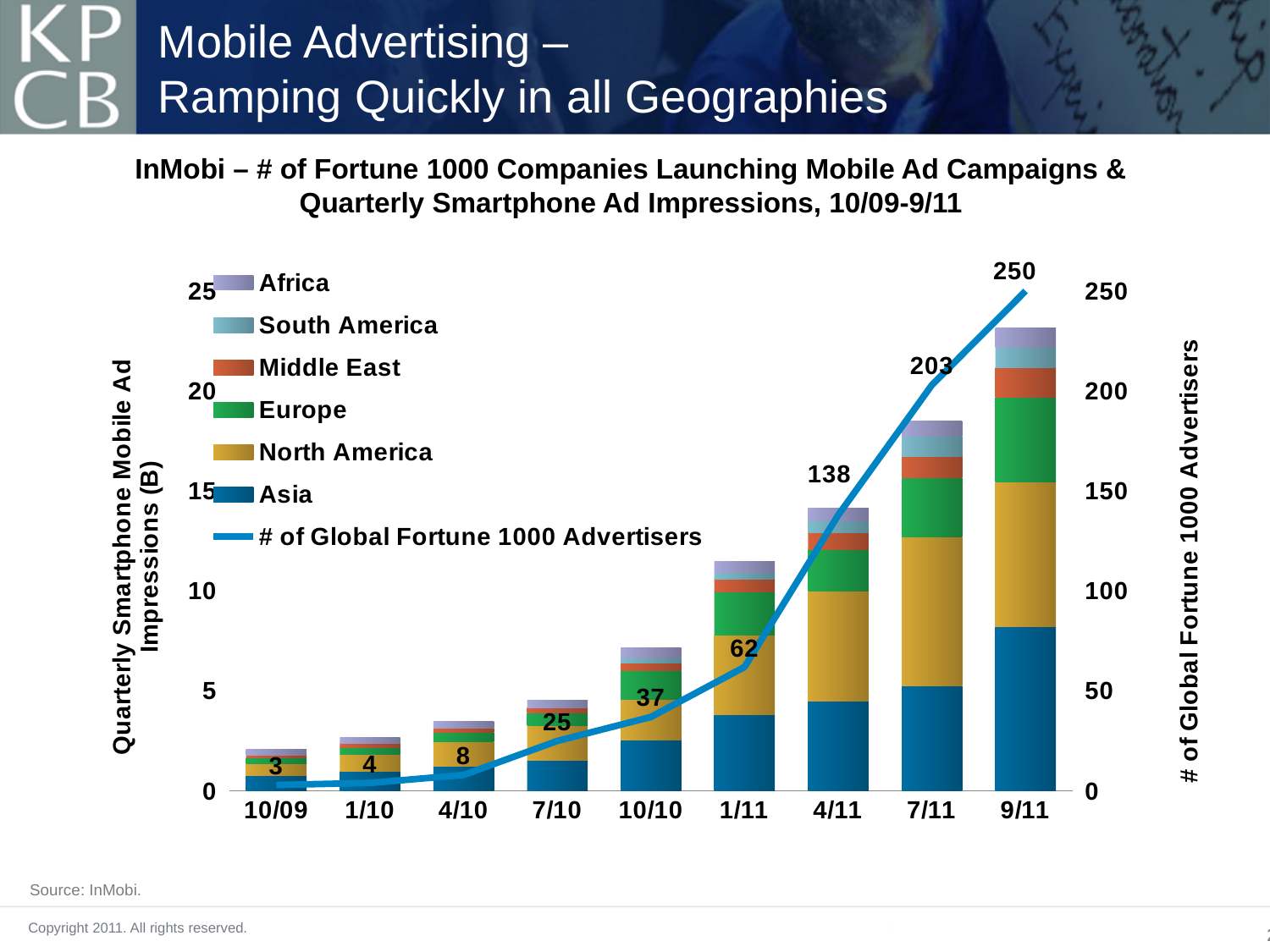
In which period is the # of Global Fortune 1000 Advertisers lowest? 10/09 What is the difference in # of Global Fortune 1000 Advertisers between 4/11 and 1/11? 76 In which period is the # of Global Fortune 1000 Advertisers highest? 9/11 What is the # of Global Fortune 1000 Advertisers at 9/11? 250 How many time periods are shown on the x axis? 9 By how much did the # of Global Fortune 1000 Advertisers increase from 7/11 to 9/11? 47 How many series does the legend list? 7 Does the # of Global Fortune 1000 Advertisers rise or fall from 10/09 to 9/11? rise What is the # of Global Fortune 1000 Advertisers at 7/10? 25 Is the total quarterly smartphone mobile ad impressions bar for 9/11 greater or less than 20 billion? greater Which period has more Global Fortune 1000 Advertisers, 10/10 or 1/11? 1/11 What is the # of Global Fortune 1000 Advertisers at 4/11? 138